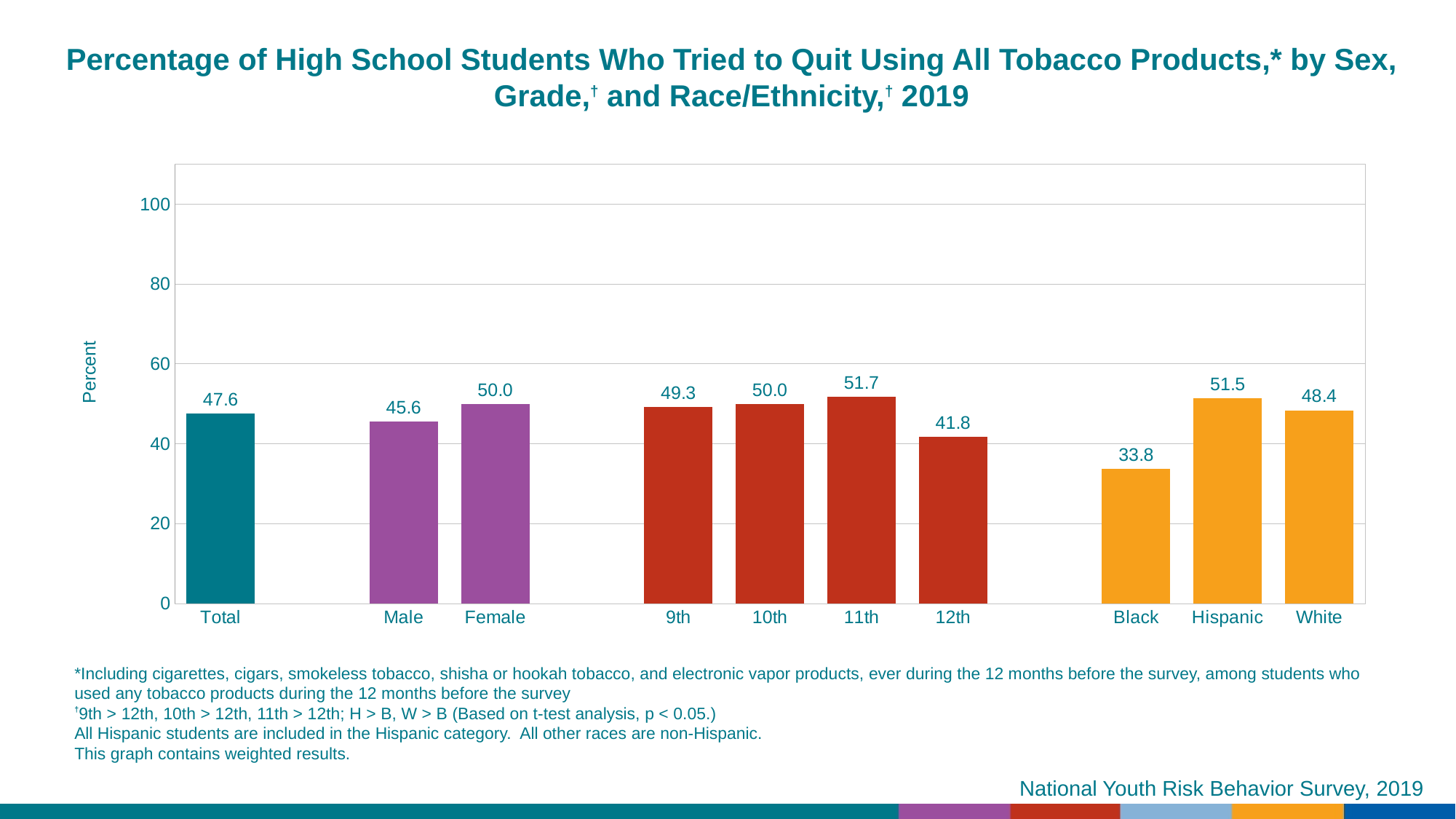
What is the difference between the Hispanic and Black values? 17.7 What is the difference between the Female and Male values? 4.4 Is the value for White greater or less than 40? greater What is the value for 12th grade? 41.8 Which is larger, the value for 9th grade or the value for 12th grade? 9th What is the value for Total? 47.6 What is the value for Black students? 33.8 Which category has the highest value? 11th How many bars are shown in the chart? 10 What is the label of the y axis? Percent Which category has the lowest value? Black What kind of chart is shown on the slide? bar chart